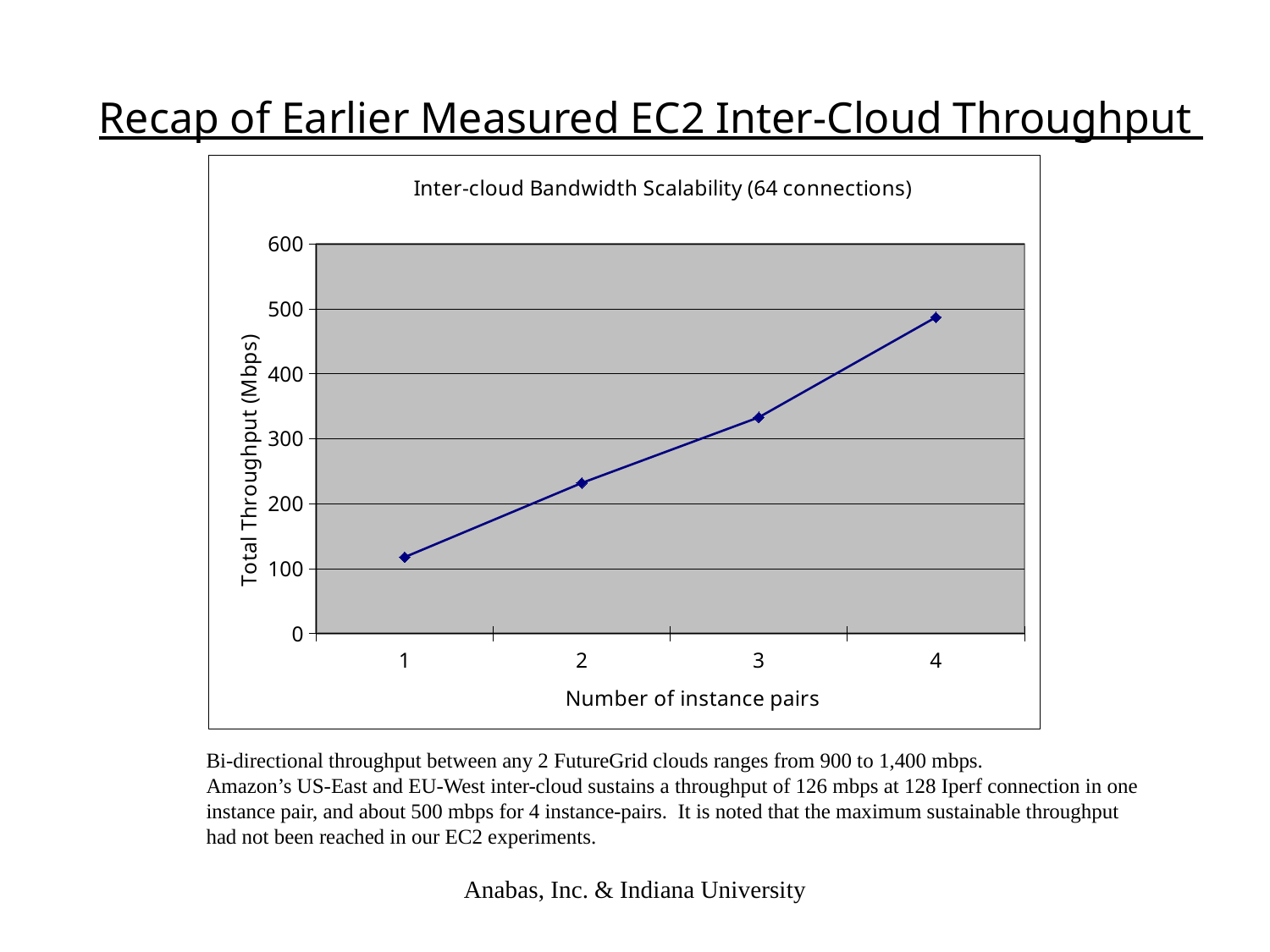
Is the total throughput for 4 instance pairs greater or less than 400? greater How many data points are plotted on the line? 4 Which number of instance pairs has the lowest total throughput? 1 Is the total throughput for 3 instance pairs greater or less than 400? less What is the label of the y axis? Total Throughput (Mbps) Does the total throughput rise or fall as the number of instance pairs increases? rise What kind of chart is shown on the slide? line chart Which number of instance pairs has the highest total throughput? 4 Is the total throughput for 1 instance pair greater or less than 200? less Which has the larger total throughput, 2 instance pairs or 3 instance pairs? 3 instance pairs What is the title of the chart? Inter-cloud Bandwidth Scalability (64 connections)